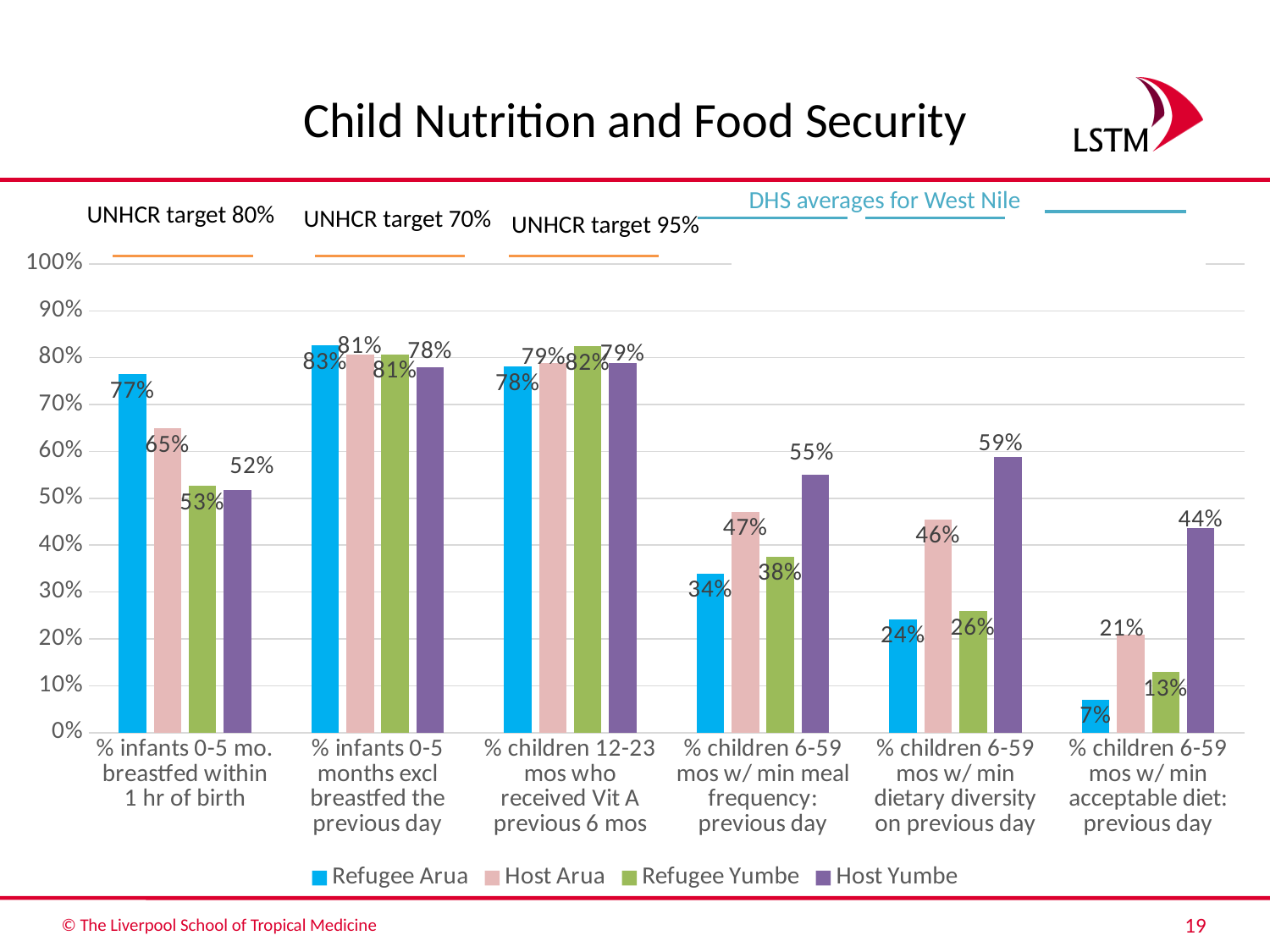
What is the value for Refugee Arua in the '% infants 0-5 mo. breastfed within 1 hr of birth' category? 77% What is the difference between Host Arua and Refugee Arua in the '% children 6-59 mos w/ min dietary diversity on previous day' category? 22% How many categories are shown on the x axis? 6 In the '% infants 0-5 mo. breastfed within 1 hr of birth' category, which is larger: Host Arua or Refugee Yumbe? Host Arua What is the value for Host Yumbe in the '% children 6-59 mos w/ min dietary diversity on previous day' category? 59% Which series has the lowest value in the '% children 6-59 mos w/ min acceptable diet: previous day' category? Refugee Arua What is the difference between Host Yumbe and Refugee Yumbe in the '% children 6-59 mos w/ min acceptable diet: previous day' category? 31% What is the UNHCR target shown above the '% children 12-23 mos who received Vit A previous 6 mos' category? 95% How many series does the legend list? 4 What kind of chart is shown on the slide? Bar chart What is the value for Refugee Yumbe in the '% children 6-59 mos w/ min acceptable diet: previous day' category? 13% Which series has the highest value in the '% children 6-59 mos w/ min meal frequency: previous day' category? Host Yumbe